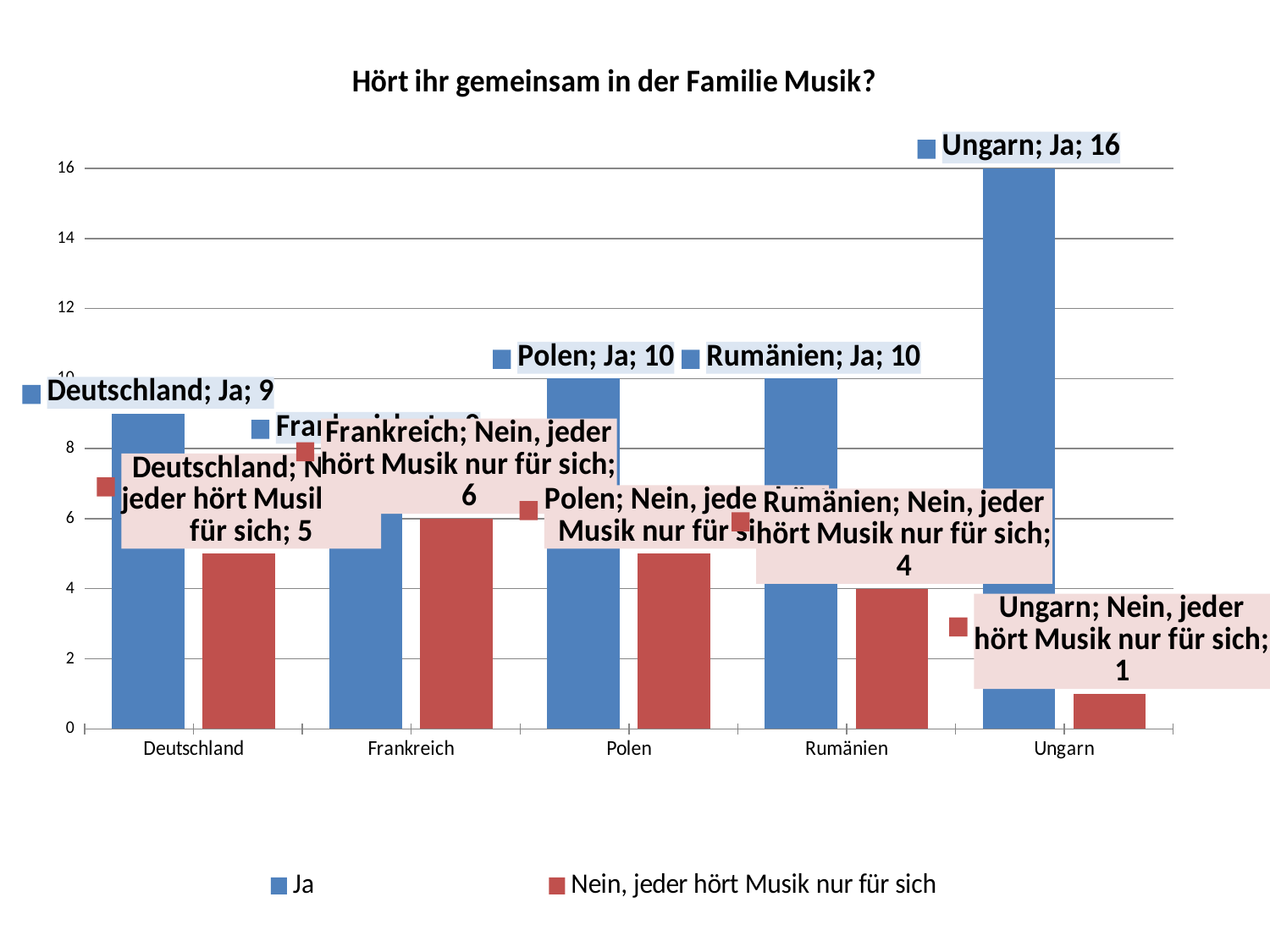
What is the value for Rumänien in the 'Nein, jeder hört Musik nur für sich' series? 4 How many countries are shown on the x axis? 5 Which country has the lowest value in the 'Ja' series? Frankreich For Deutschland, which is larger: the 'Ja' value or the 'Nein' value? Ja Which country has the lowest value in the 'Nein, jeder hört Musik nur für sich' series? Ungarn What is the difference between the 'Ja' and 'Nein' values for Ungarn? 15 What is the value for Ungarn in the 'Ja' series? 16 What is the value for Polen in the 'Ja' series? 10 Which country has the highest value in the 'Ja' series? Ungarn How many series does the legend list? 2 What is the value for Deutschland in the 'Nein, jeder hört Musik nur für sich' series? 5